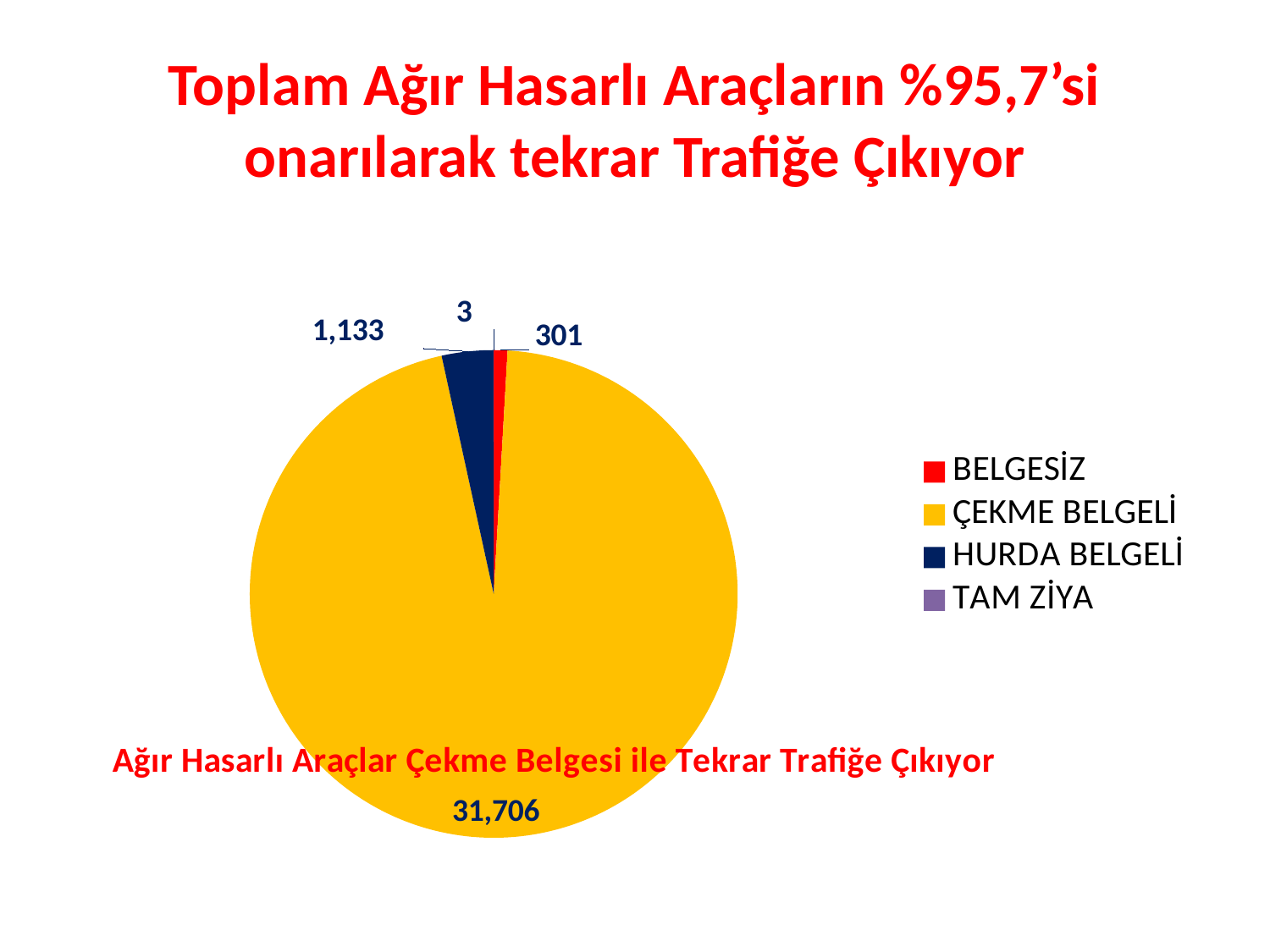
What is the total of all the values shown in the pie chart? 33,143 What is the value for ÇEKME BELGELİ in the pie chart? 31,706 Which category has the smallest slice in the pie chart? TAM ZİYA What type of chart is shown on the slide? pie chart What is the difference between the values for HURDA BELGELİ and BELGESİZ? 832 What colour is the ÇEKME BELGELİ slice in the pie chart? yellow What is the value for HURDA BELGELİ in the pie chart? 1,133 How many categories does the legend of the pie chart list? 4 What is the value for TAM ZİYA in the pie chart? 3 Which category has the largest slice in the pie chart? ÇEKME BELGELİ What is the value for BELGESİZ in the pie chart? 301 Which is larger, the value for HURDA BELGELİ or the value for BELGESİZ? HURDA BELGELİ